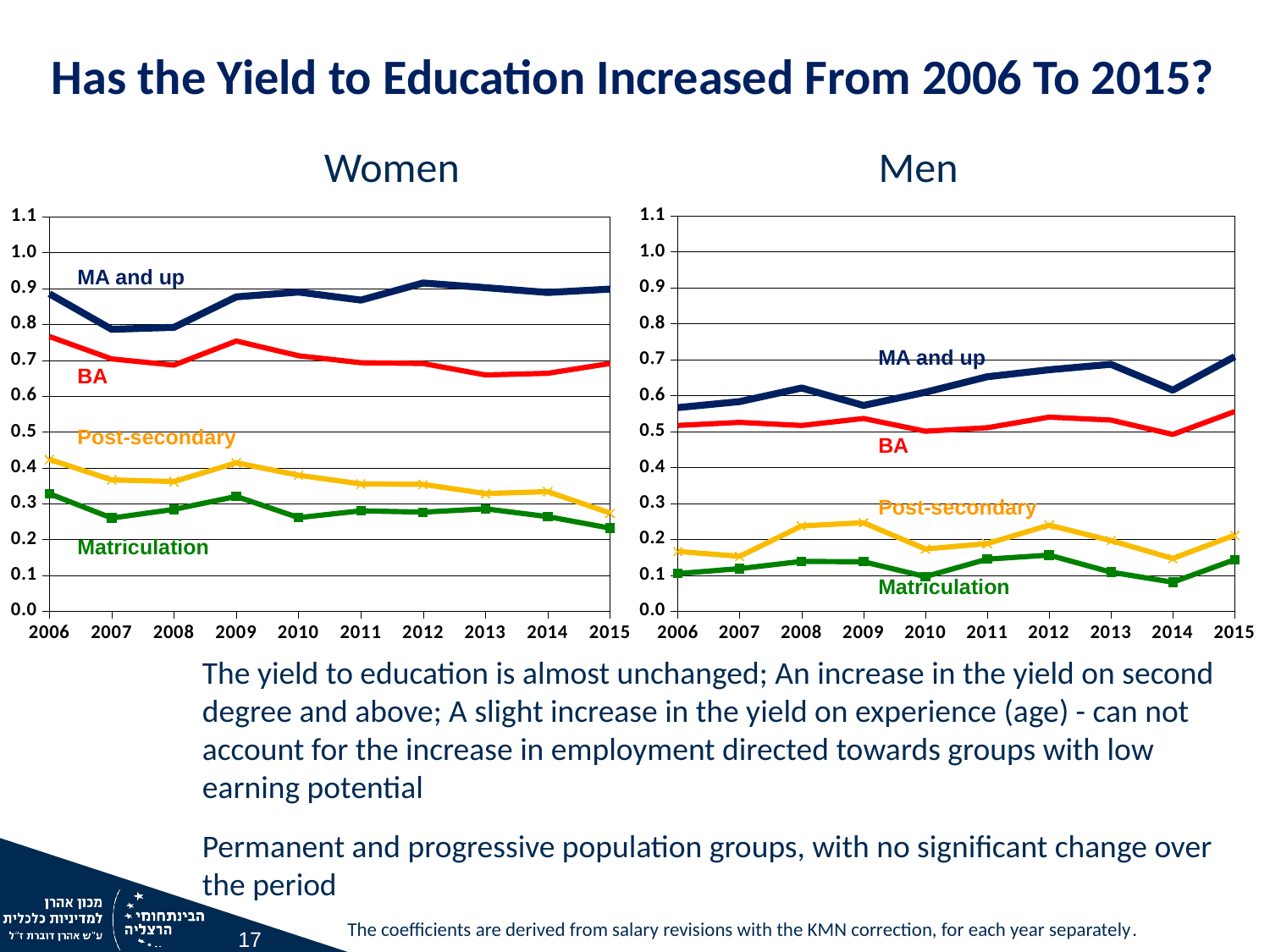
In the Women chart, is the value for MA and up in 2006 greater or less than 0.8? greater In the Men chart, is the value for MA and up in 2014 greater or less than 0.7? less In the Women chart, which series has the highest values across the whole period? MA and up Which is larger: the BA value for Women in 2015 or the BA value for Men in 2015? Women How many years are plotted along the x axis of the Men chart? 10 How many series are labelled on the Women chart? 4 In the Men chart, which series has the lowest values across the whole period? Matriculation What kind of chart is the Women chart? line chart In the Women chart, does the Post-secondary series generally rise or fall from 2006 to 2015? fall In the Women chart, is the value for Post-secondary in 2015 greater or less than 0.3? less In the Men chart, does the MA and up series generally rise or fall from 2006 to 2015? rise